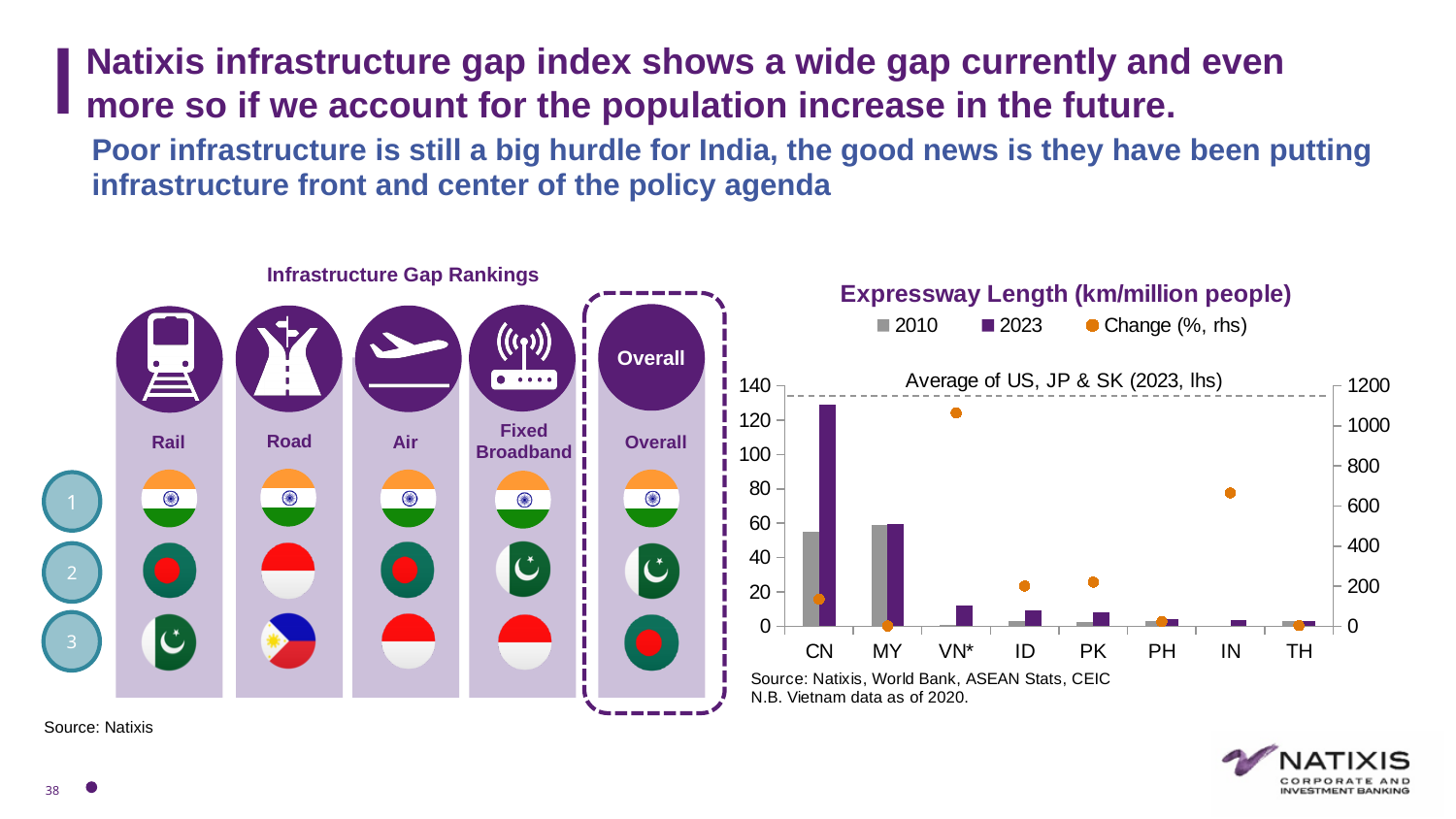
Is the Change (%, rhs) value for VN* in the Expressway Length chart greater or less than 1000? greater What kind of chart is the Expressway Length chart? bar chart What does the dashed horizontal line in the Expressway Length chart represent? Average of US, JP & SK (2023, lhs) Which country has the highest 2023 bar in the Expressway Length chart? CN What is the title of the chart on the right of the slide? Expressway Length (km/million people) How many series does the legend of the Expressway Length chart list? 3 Is the 2023 value for CN in the Expressway Length chart greater or less than 100? greater Which country has the highest Change (%, rhs) marker in the Expressway Length chart? VN* Is the Change (%, rhs) value for IN in the Expressway Length chart greater or less than 600? greater Which is larger in the Expressway Length chart: the 2023 value for CN or the 2023 value for MY? CN How many countries are shown on the x axis of the Expressway Length chart? 8